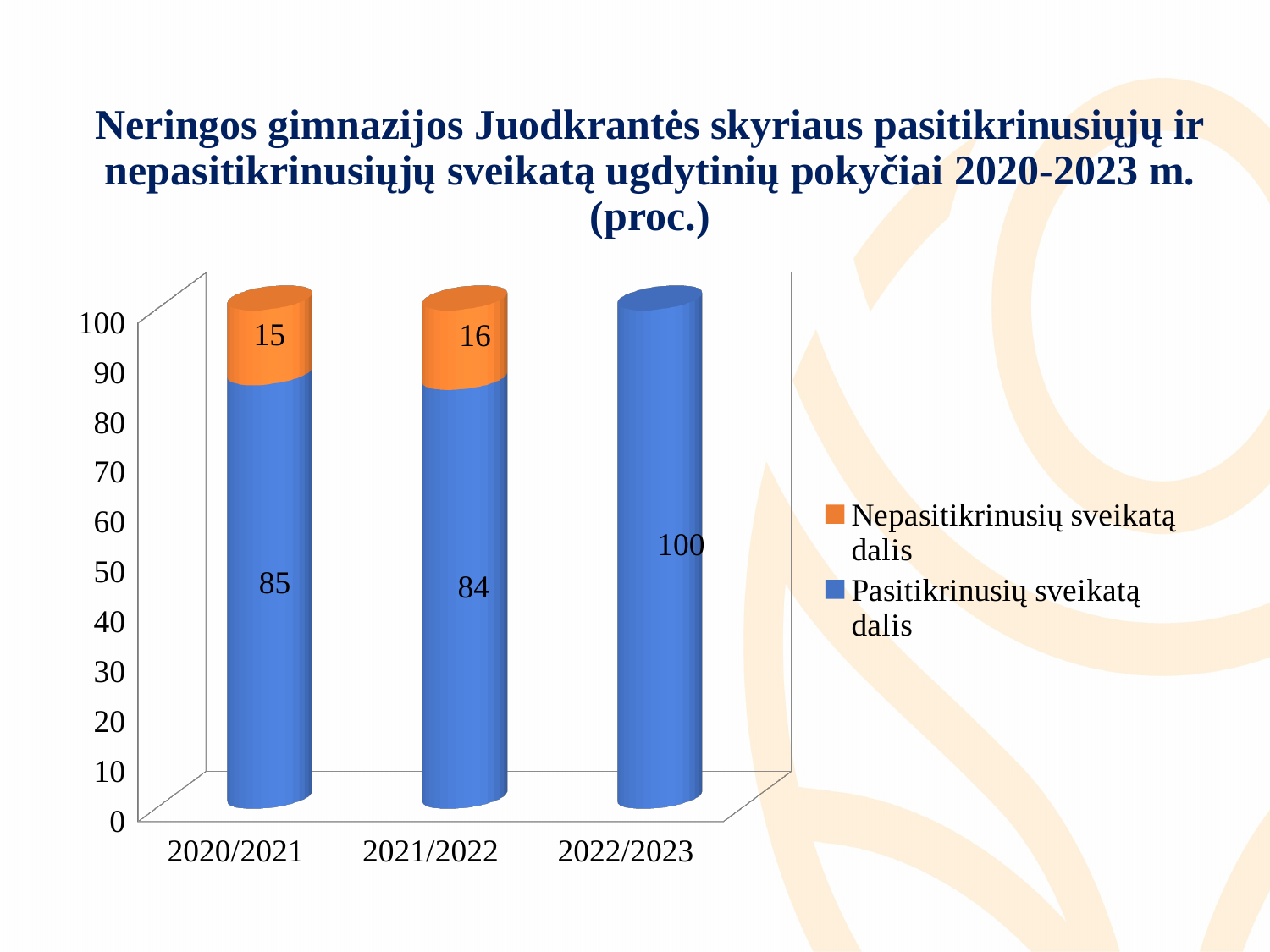
How many year categories are shown on the x axis? 3 In which year is 'Pasitikrinusių sveikatą dalis' lowest? 2021/2022 What kind of chart is shown on the slide? Stacked bar chart What is the value of 'Pasitikrinusių sveikatą dalis' for 2022/2023? 100 Which is larger: 'Nepasitikrinusių sveikatą dalis' in 2020/2021 or in 2021/2022? 2021/2022 What is the value of 'Pasitikrinusių sveikatą dalis' for 2020/2021? 85 How many series does the legend list? 2 What is the value of 'Nepasitikrinusių sveikatą dalis' for 2020/2021? 15 What is the value of 'Nepasitikrinusių sveikatą dalis' for 2021/2022? 16 What is the difference between 'Pasitikrinusių sveikatą dalis' in 2022/2023 and in 2020/2021? 15 What is the total of the stacked bar for 2021/2022? 100 In which year is 'Pasitikrinusių sveikatą dalis' highest? 2022/2023